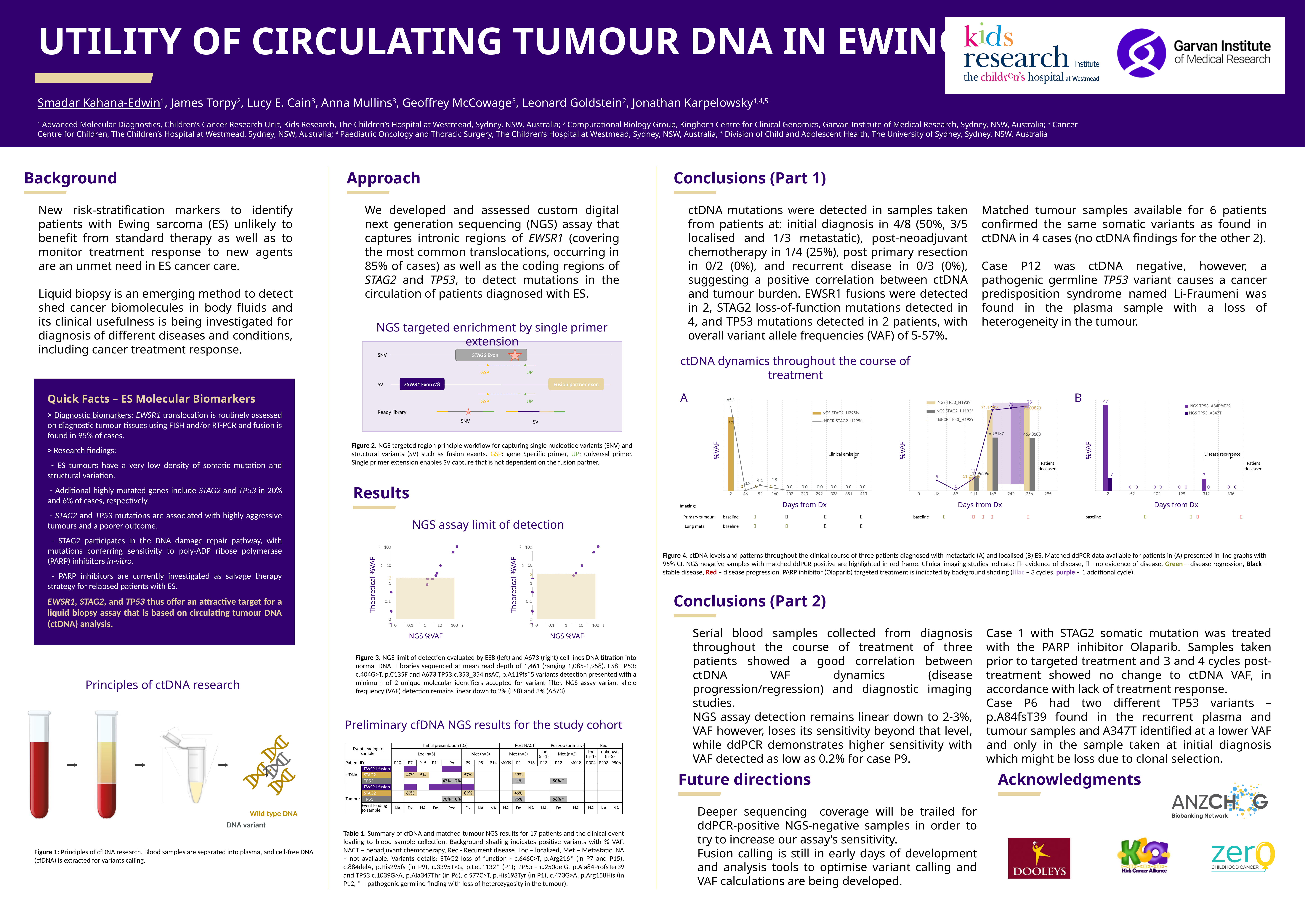
In the 'ctDNA dynamics throughout the course of treatment' figure, panel A left chart, what is the x-axis label? Days from Dx In the 'ctDNA dynamics throughout the course of treatment' figure, panel A middle chart, how many series does the legend list? 3 In the 'ctDNA dynamics throughout the course of treatment' figure, panel A left chart, do the %VAF values generally rise or fall along the x axis? fall In the 'ctDNA dynamics throughout the course of treatment' figure, panel B chart, how many series does the legend list? 2 In the 'NGS assay limit of detection' figure, what is the y-axis label of the left chart? Theoretical %VAF In the 'NGS assay limit of detection' figure, what kind of chart is shown? scatter plot In the 'ctDNA dynamics throughout the course of treatment' figure, panel B chart, what is the value of NGS TP53_A84PfsT39 at day 2? 47 In the 'ctDNA dynamics throughout the course of treatment' figure, panel A left chart, what is the ddPCR STAG2_H295fs value at day 2? 65.1 In the 'ctDNA dynamics throughout the course of treatment' figure, panel A left chart, what is the NGS STAG2_H295fs value at day 2? 57 In the 'ctDNA dynamics throughout the course of treatment' figure, panel A left chart, how many series does the legend list? 2 In the 'ctDNA dynamics throughout the course of treatment' figure, panel A left chart, what is the difference between the ddPCR value (65.1) and the NGS value (57) at day 2? 8.1 In the 'ctDNA dynamics throughout the course of treatment' figure, panel B chart, at which day is the highest %VAF value? 2